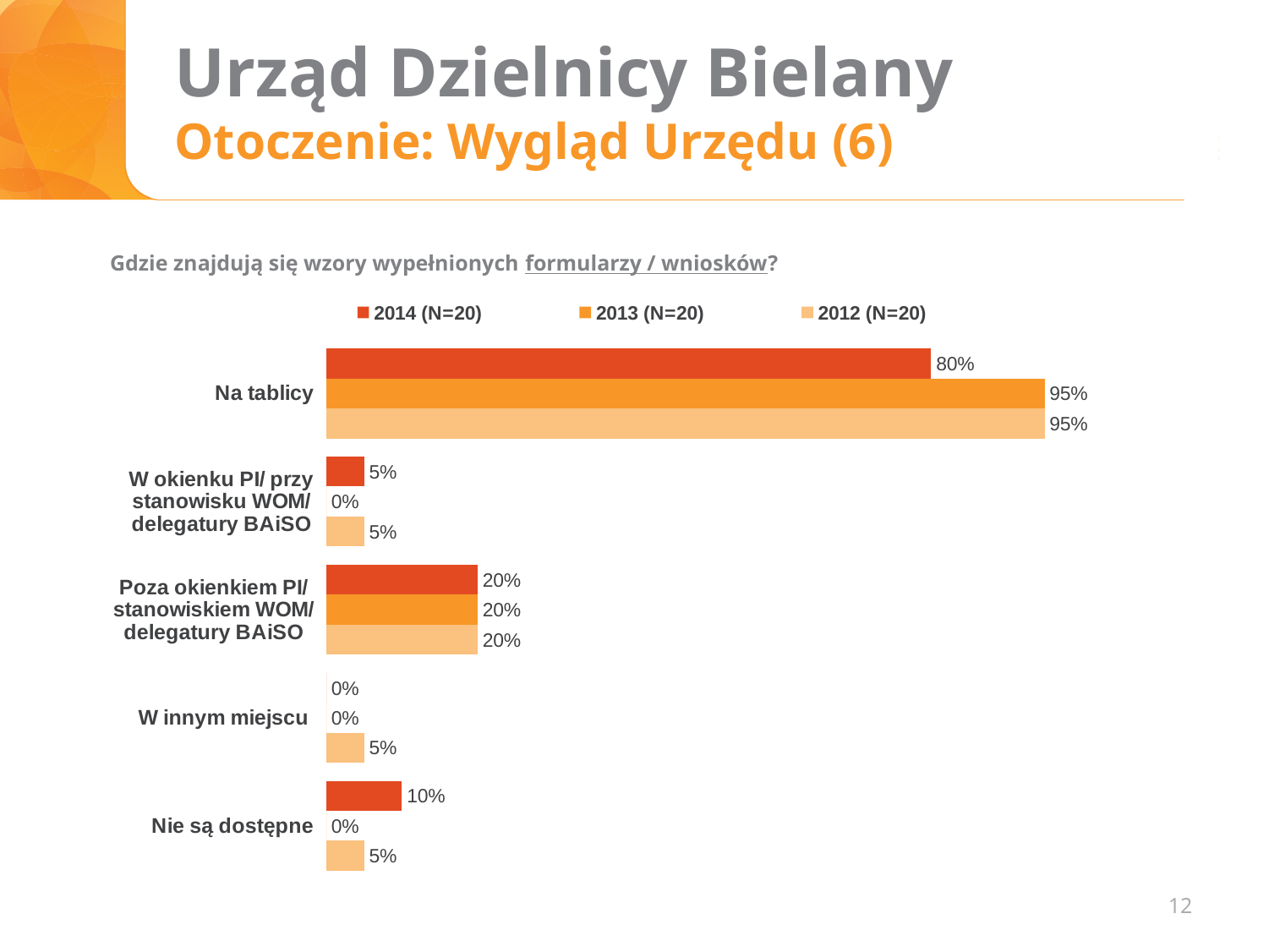
What kind of chart is shown on the slide? bar chart What is the value for "W innym miejscu" in the 2012 (N=20) series? 5% What question is the chart answering, according to the text above it? Gdzie znajdują się wzory wypełnionych formularzy / wniosków? What is the value for "Na tablicy" in the 2013 (N=20) series? 95% How many series does the legend list? 3 Which is larger for "Nie są dostępne": the 2014 (N=20) value or the 2012 (N=20) value? 2014 (N=20) What is the value for "Poza okienkiem PI/ stanowiskiem WOM/ delegatury BAiSO" in the 2012 (N=20) series? 20% What is the difference between the 2013 (N=20) and 2014 (N=20) values for "Na tablicy"? 15% What is the value for "Na tablicy" in the 2014 (N=20) series? 80% How many categories are shown on the chart? 5 What is the value for "Nie są dostępne" in the 2014 (N=20) series? 10% Which category has the highest value in the 2014 (N=20) series? Na tablicy